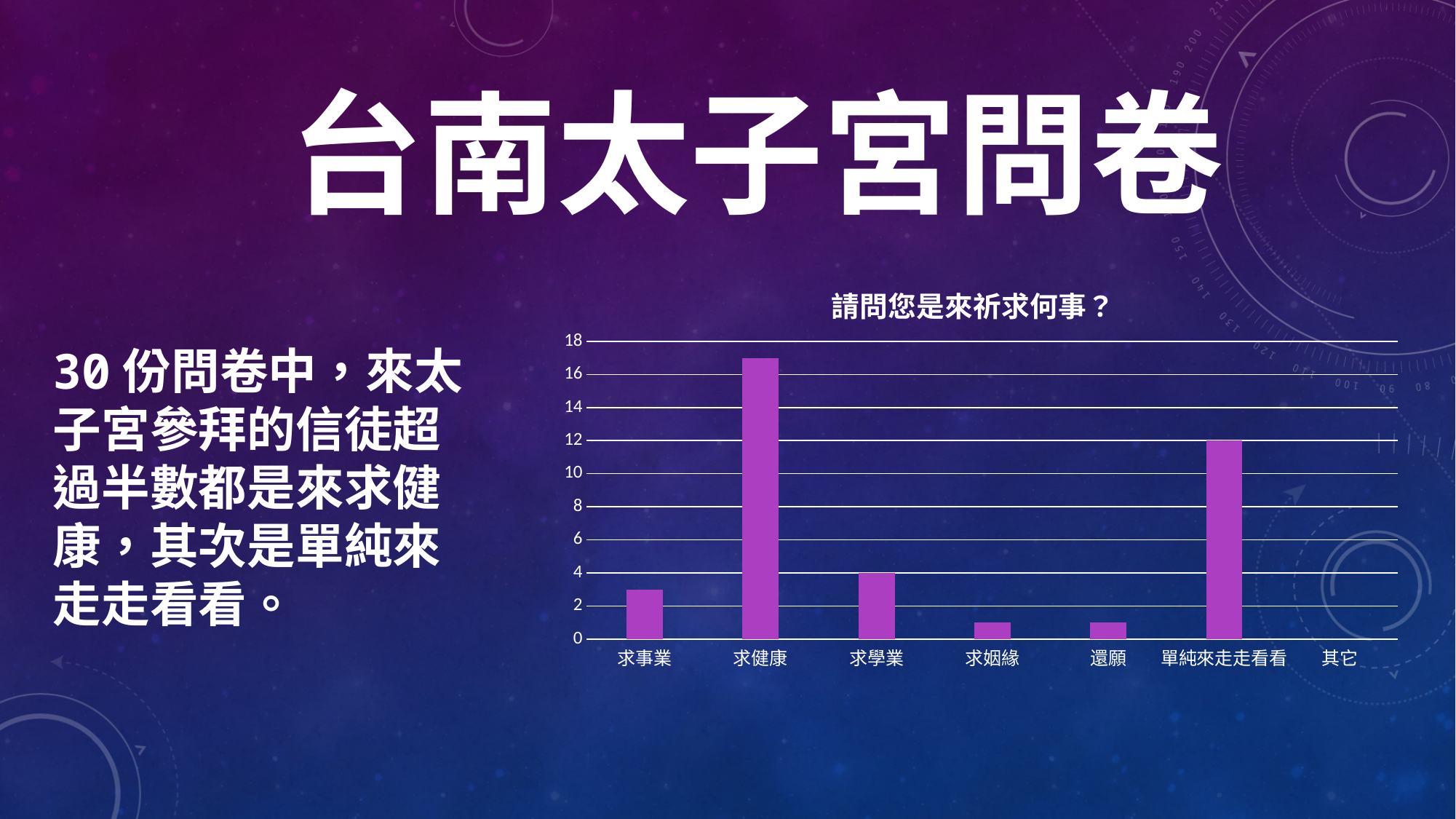
What is the title of the chart? 請問您是來祈求何事？ Which category has the lowest value in the chart? 其它 How many categories are shown on the x axis of the chart? 7 Is the value for 求事業 greater or less than 4? less Which category has the highest value in the chart? 求健康 What is the difference between the values for 單純來走走看看 and 求學業? 8 Which is larger, the value for 求健康 or the value for 單純來走走看看? 求健康 Is the value for 求姻緣 greater or less than 2? less What is the value for 單純來走走看看? 12 What is the value for 求學業? 4 What kind of chart is shown on the slide? bar chart Is the value for 求健康 greater or less than 16? greater